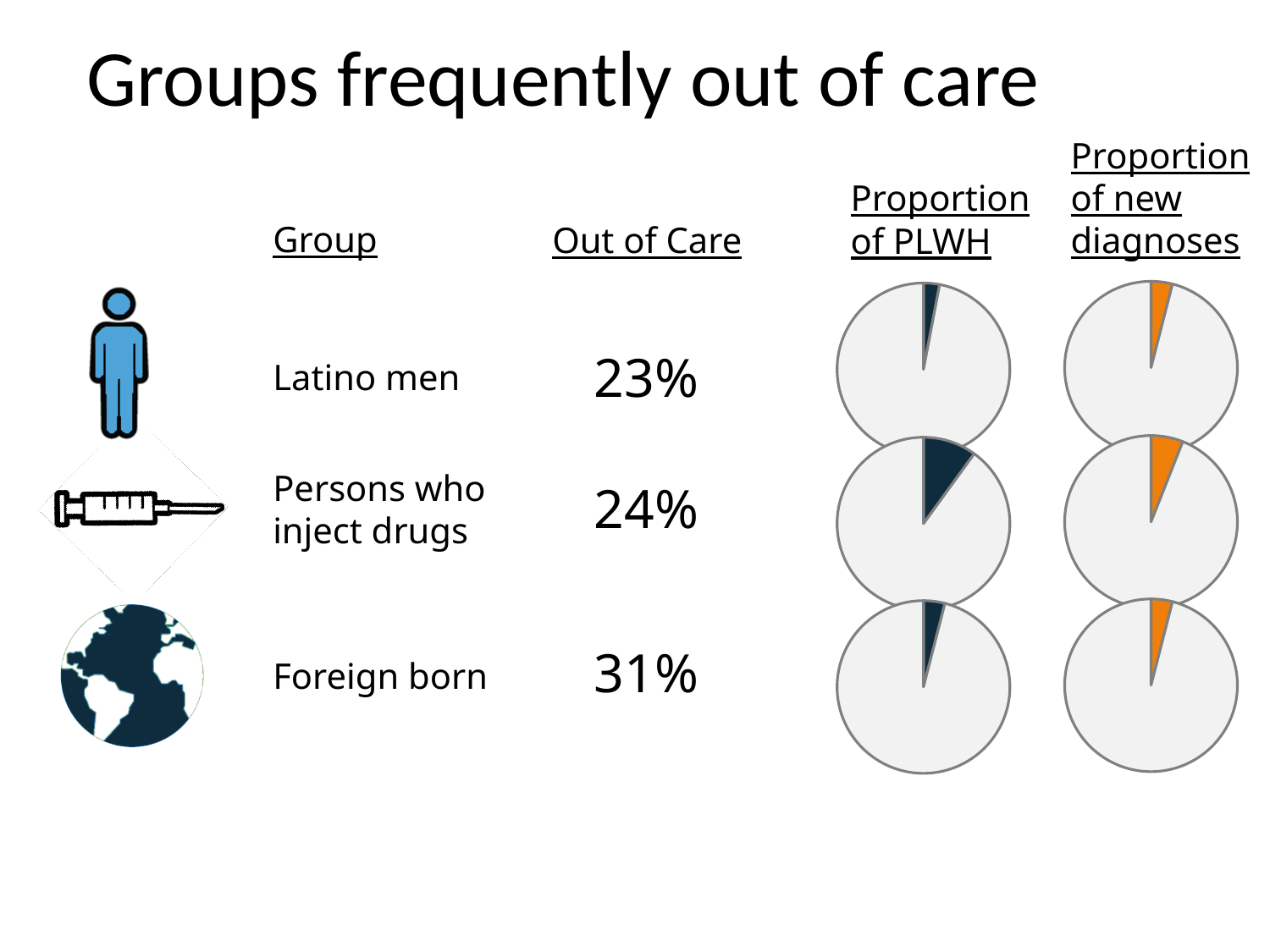
In the 'Proportion of PLWH' column, is the highlighted slice for Persons who inject drugs larger or smaller than the slice for Latino men? Larger What colour are the highlighted slices in the 'Proportion of PLWH' pie charts? Dark navy blue Which group has the highest 'Out of Care' value? Foreign born What is the 'Out of Care' value shown for Latino men? 23% In the 'Proportion of PLWH' column, which group has the largest highlighted slice? Persons who inject drugs In the 'Proportion of new diagnoses' column, which group has the largest highlighted slice? Persons who inject drugs How many pie charts are in the 'Proportion of PLWH' column? 3 What is the 'Out of Care' value shown for Foreign born? 31% What kind of charts are shown in the 'Proportion of PLWH' and 'Proportion of new diagnoses' columns? Pie charts How many pie charts are shown on the slide in total? 6 What colour are the highlighted slices in the 'Proportion of new diagnoses' pie charts? Orange In the 'Proportion of new diagnoses' column, is the highlighted slice for Persons who inject drugs larger or smaller than the slice for Foreign born? Larger